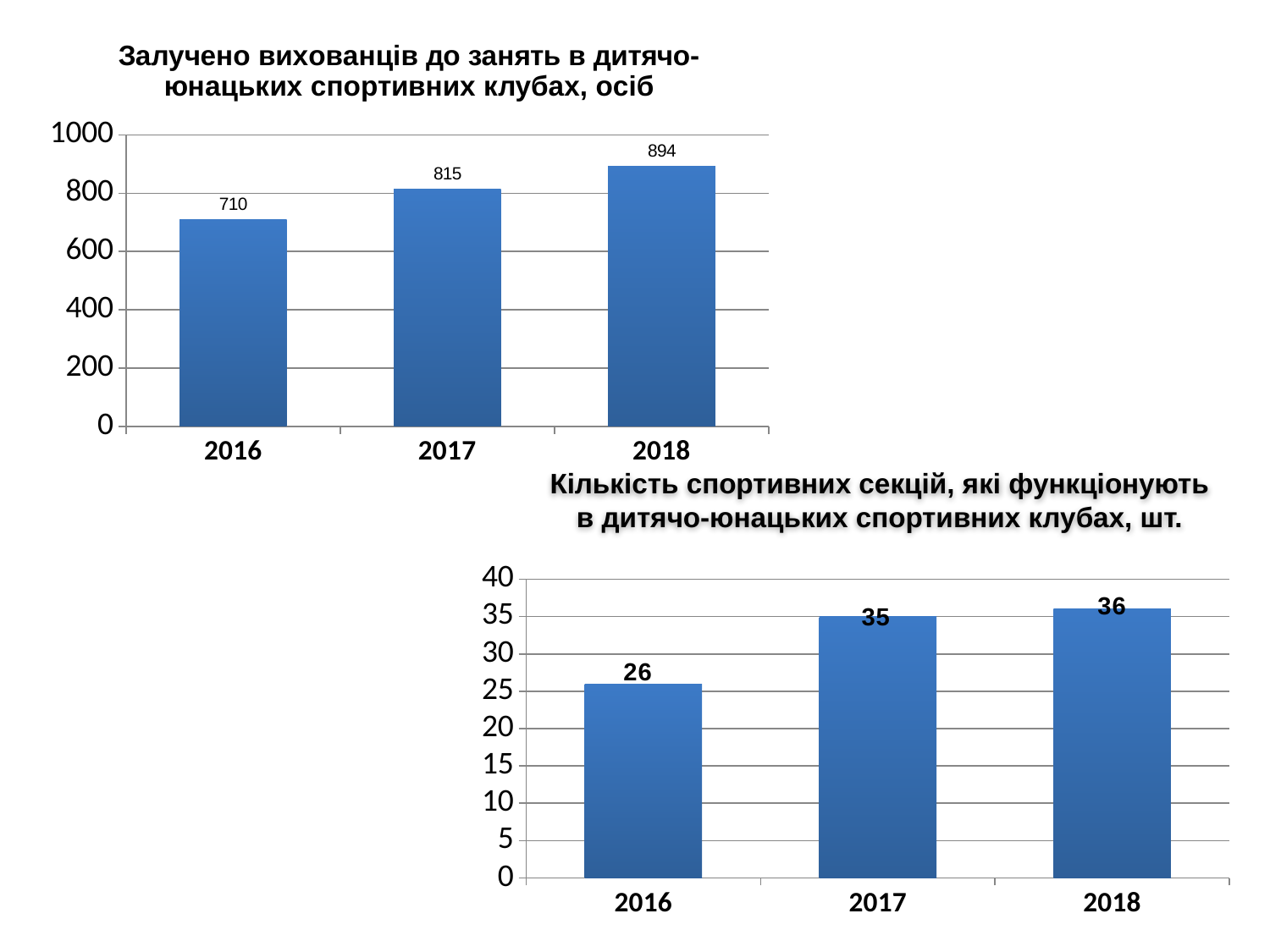
In the top chart (Залучено вихованців до занять в дитячо-юнацьких спортивних клубах, осіб), is the value for 2017 greater or less than 800? greater What kind of chart is the top chart (Залучено вихованців до занять в дитячо-юнацьких спортивних клубах, осіб)? bar chart In the bottom chart (Кількість спортивних секцій, які функціонують в дитячо-юнацьких спортивних клубах, шт.), which is larger, the value for 2016 or the value for 2018? 2018 In the bottom chart (Кількість спортивних секцій, які функціонують в дитячо-юнацьких спортивних клубах, шт.), what is the difference between the 2017 and 2016 values? 9 In the top chart (Залучено вихованців до занять в дитячо-юнацьких спортивних клубах, осіб), which year has the highest value? 2018 In the top chart (Залучено вихованців до занять в дитячо-юнацьких спортивних клубах, осіб), what is the value for 2016? 710 In the top chart (Залучено вихованців до занять в дитячо-юнацьких спортивних клубах, осіб), do the values rise or fall from 2016 to 2018? rise In the top chart (Залучено вихованців до занять в дитячо-юнацьких спортивних клубах, осіб), what is the difference between the 2018 and 2016 values? 184 In the bottom chart (Кількість спортивних секцій, які функціонують в дитячо-юнацьких спортивних клубах, шт.), which year has the lowest value? 2016 In the bottom chart (Кількість спортивних секцій, які функціонують в дитячо-юнацьких спортивних клубах, шт.), what is the value for 2017? 35 How many years are shown in the bottom chart (Кількість спортивних секцій, які функціонують в дитячо-юнацьких спортивних клубах, шт.)? 3 In the top chart (Залучено вихованців до занять в дитячо-юнацьких спортивних клубах, осіб), what is the value for 2018? 894